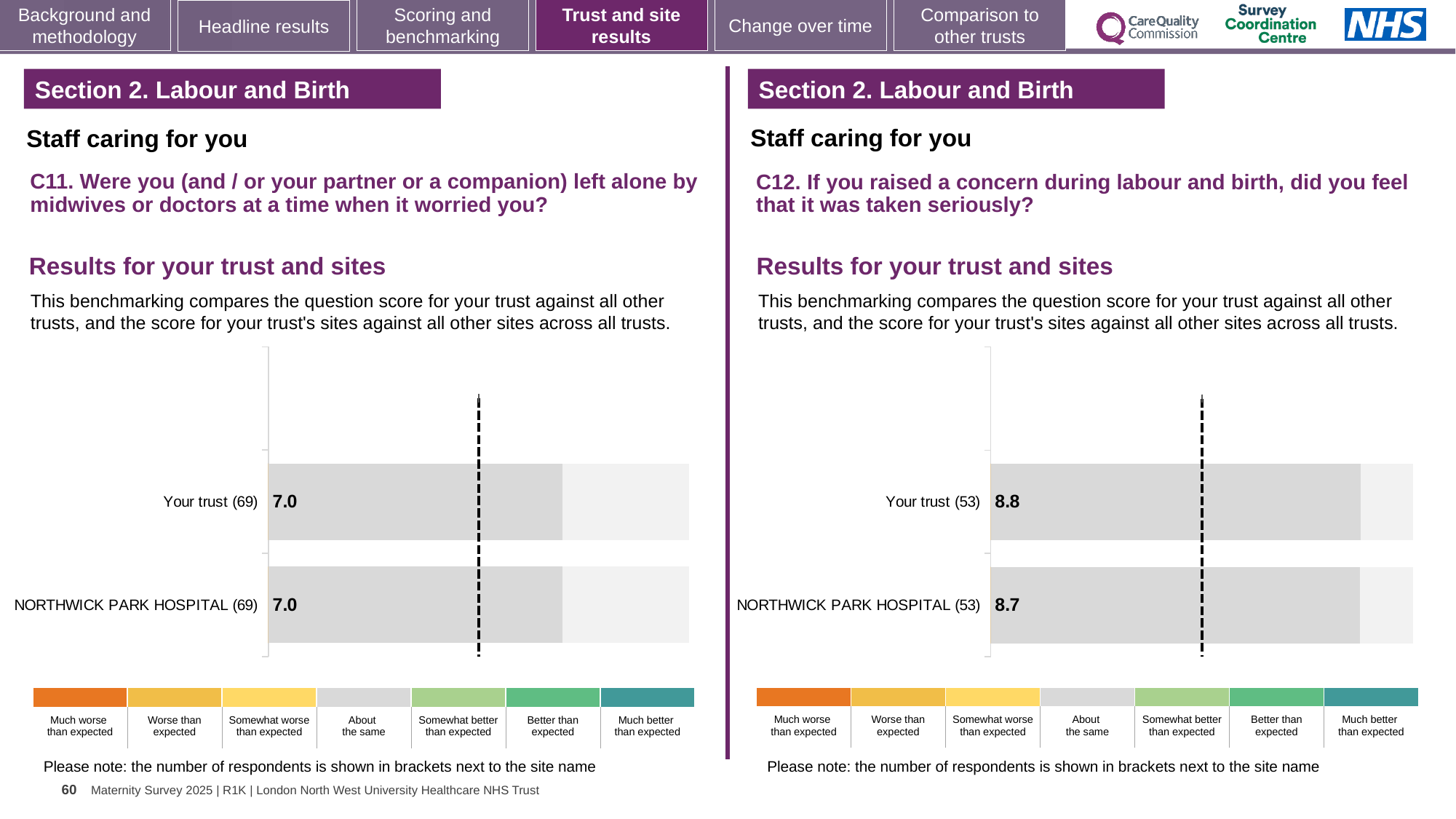
In the left chart (C11), what is the score for NORTHWICK PARK HOSPITAL? 7.0 In the right chart (C12), what is the score for NORTHWICK PARK HOSPITAL? 8.7 Is the score for Your trust in the right chart (C12) higher or lower than the score for Your trust in the left chart (C11)? Higher How many bars are plotted in the right chart (C12)? 2 In the left chart (C11), how many respondents are shown in brackets next to Your trust? 69 In the left chart (C11), what is the difference between the score for Your trust and the score for NORTHWICK PARK HOSPITAL? 0.0 In the right chart (C12), what is the score for Your trust? 8.8 How many bars are plotted in the left chart (C11)? 2 In the left chart (C11), what is the score for Your trust? 7.0 In the right chart (C12), how many respondents are shown in brackets next to NORTHWICK PARK HOSPITAL? 53 In the right chart (C12), what is the difference between the score for Your trust and the score for NORTHWICK PARK HOSPITAL? 0.1 What kind of chart is used in the left chart (C11)? Bar chart